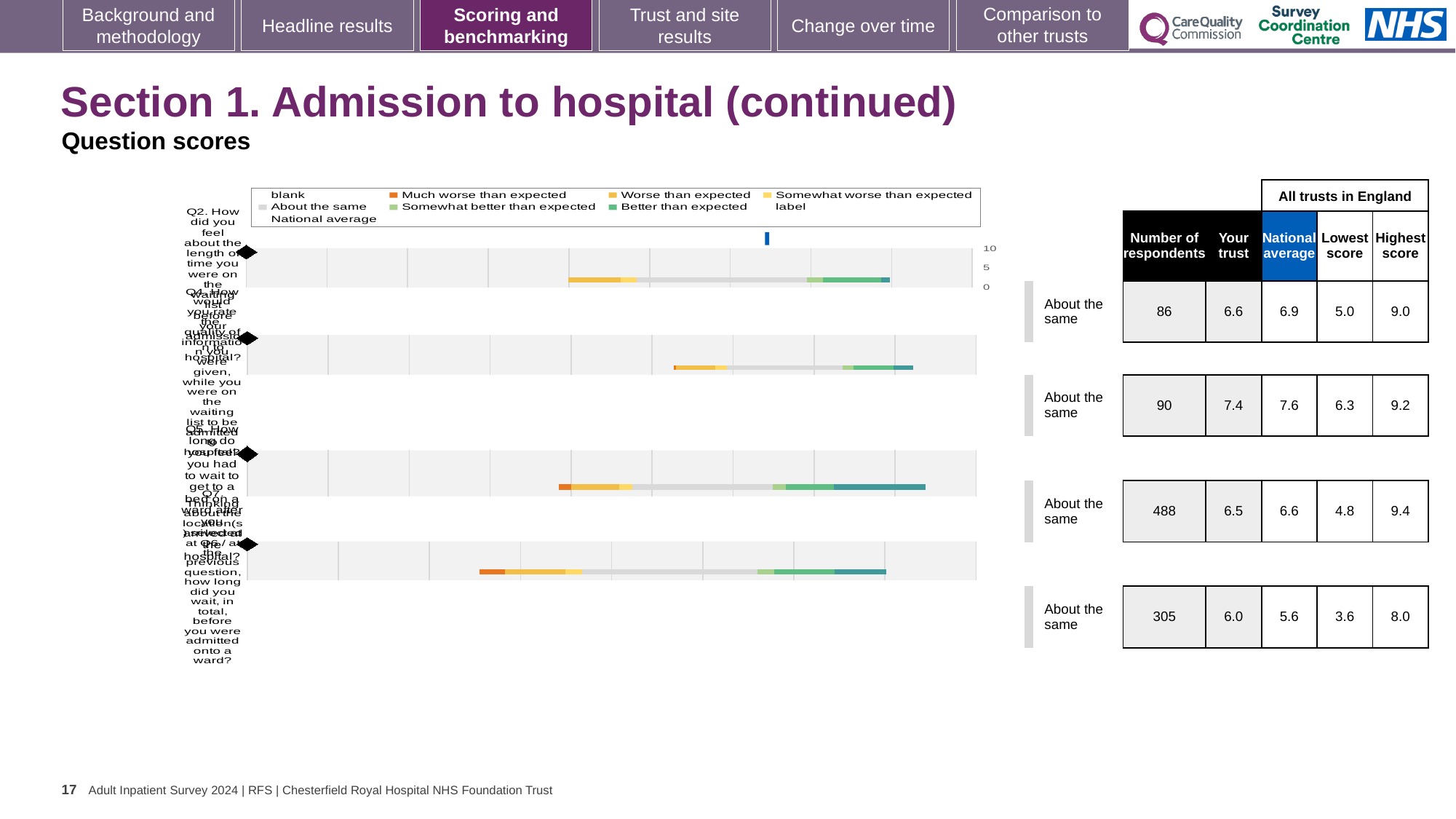
How many questions (rows) are plotted in the chart? 4 For the first row, what is the difference between the national average and the 'Your trust' score? 0.3 Which row of the table has the largest number of respondents? The third row (488) What kind of chart is shown on the slide? Bar chart What is the highest score for the fourth row of the table? 8.0 In the table next to the chart, what is the number of respondents for the first row? 86 What benchmark category label is shown beside each of the four questions? About the same For the fourth row, which is larger: the 'Your trust' score or the national average? Your trust (6.0) What is the lowest score for the third row of the table? 4.8 What is the 'Your trust' score for the first row of the table? 6.6 What is the national average for the second row of the table? 7.6 What is the number of respondents for the third row of the table? 488